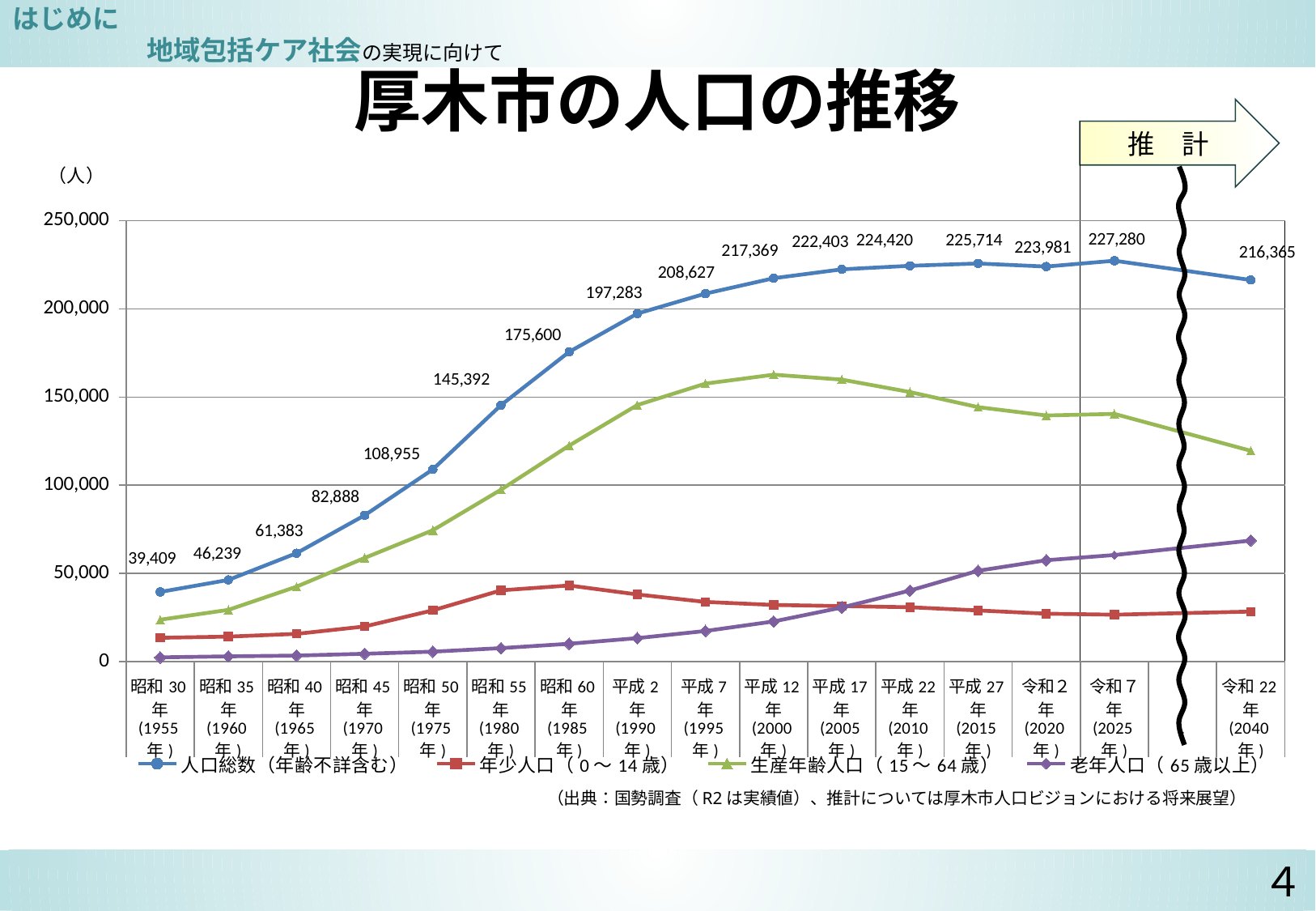
In which year does 人口総数（年齢不詳含む） reach its highest value? 令和7年(2025年) How many years are shown on the x axis? 16 Which is larger in 令和22年(2040年): 生産年齢人口（15～64歳） or 老年人口（65歳以上）? 生産年齢人口（15～64歳） What is the value of 人口総数（年齢不詳含む） for 平成12年(2000年)? 217,369 In which year is 人口総数（年齢不詳含む） lowest? 昭和30年(1955年) How many series does the legend list? 4 What is the value of 人口総数（年齢不詳含む） for 昭和30年(1955年)? 39,409 Is the value of 年少人口（0～14歳） for 昭和60年(1985年) greater or less than 50,000? less What kind of chart is shown on the slide? line chart Is the value of 生産年齢人口（15～64歳） for 平成12年(2000年) greater or less than 150,000? greater What is the value of 人口総数（年齢不詳含む） for 令和22年(2040年)? 216,365 What is the difference between 人口総数 in 令和7年(2025年) and 令和22年(2040年)? 10,915